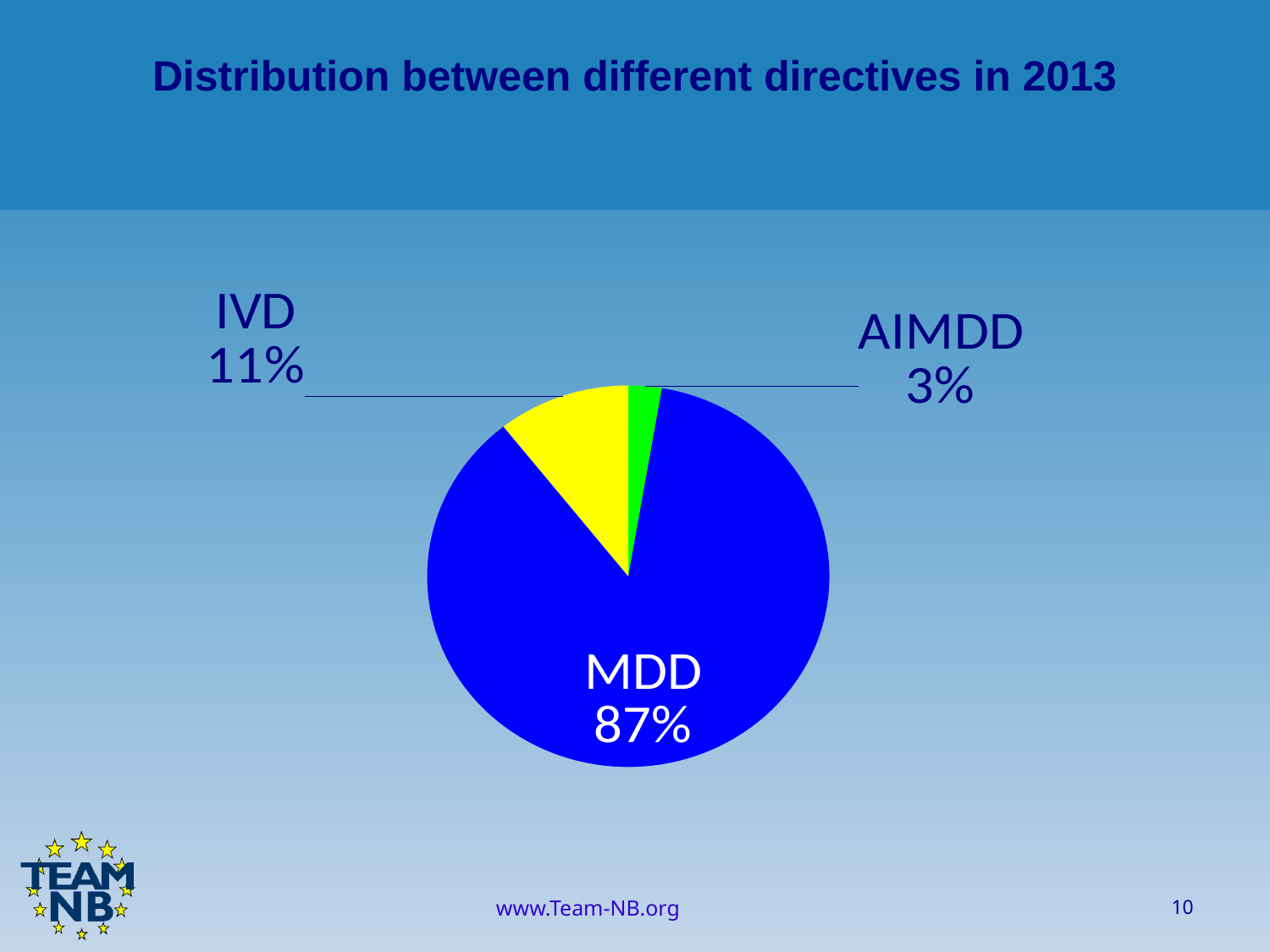
What colour is the MDD slice of the pie? blue Which has a larger share, IVD or AIMDD? IVD Which directive has the largest share of the pie? MDD Which directive has the smallest share of the pie? AIMDD What is the title of the chart? Distribution between different directives in 2013 What is the difference in percentage points between the IVD share and the AIMDD share? 8 What type of chart is shown on the slide? pie chart How many slices does the pie chart have? 3 What share of the pie does AIMDD represent? 3% What share of the pie does IVD represent? 11% What share of the pie does MDD represent? 87% What is the difference in percentage points between the MDD share and the IVD share? 76